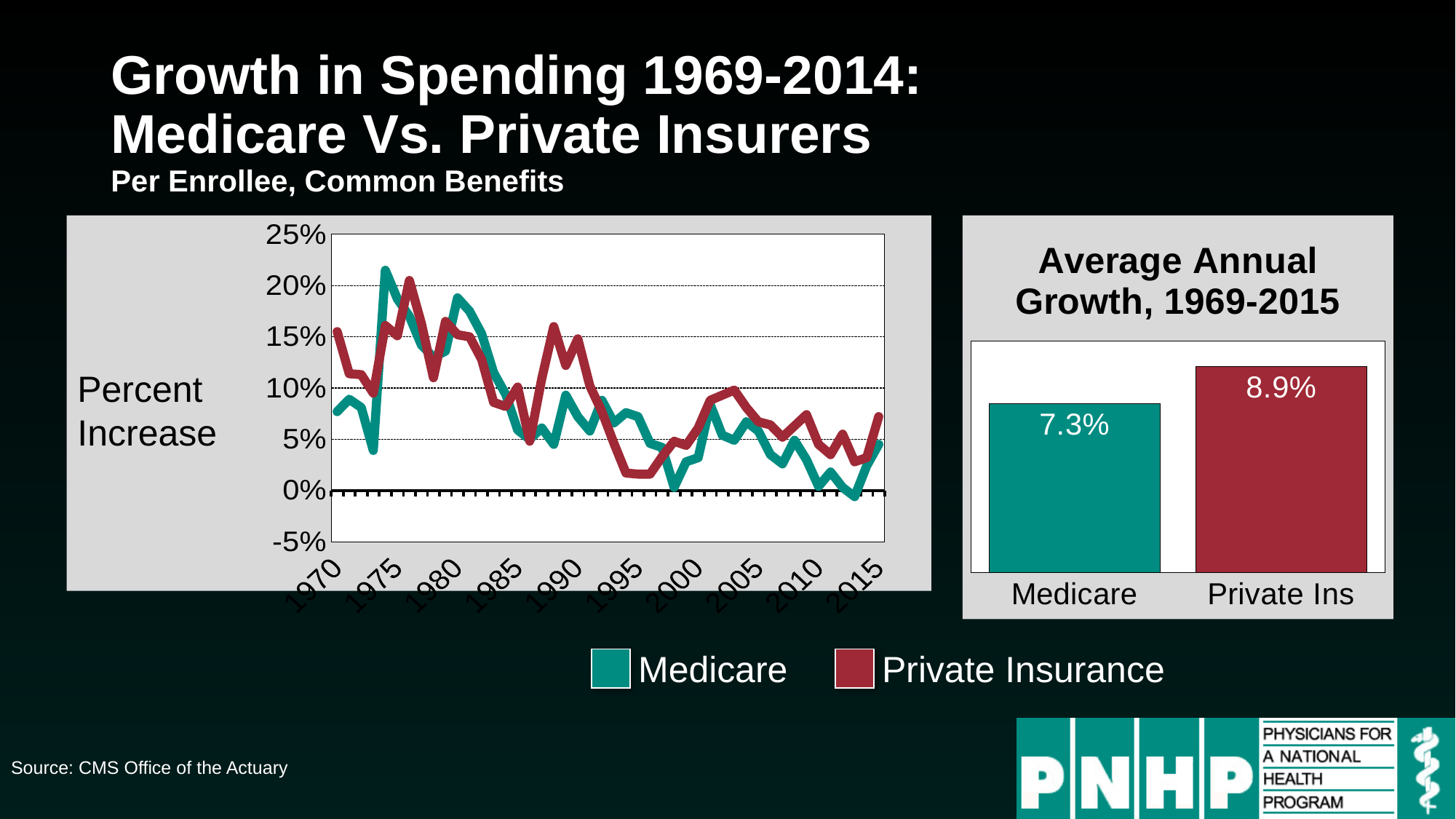
In the Average Annual Growth, 1969-2015 chart, what is the difference between Private Ins and Medicare? 1.6% In the Percent Increase chart on the left, is the Medicare value at 2015 greater or less than 10%? less In the Average Annual Growth, 1969-2015 chart, what is the value for Private Ins? 8.9% In the Percent Increase chart on the left, which series has the higher value around 1990, Medicare or Private Insurance? Private Insurance In the Percent Increase chart on the left, is the Private Insurance value around 1990 greater or less than 10%? greater What kind of chart is the Percent Increase chart on the left? line chart How many categories are shown in the Average Annual Growth, 1969-2015 chart? 2 What kind of chart is the Average Annual Growth, 1969-2015 chart? bar chart In the Average Annual Growth, 1969-2015 chart, which category has the higher value? Private Ins How many series does the legend list for the Percent Increase chart on the left? 2 In the Average Annual Growth, 1969-2015 chart, what is the value for Medicare? 7.3% In the Percent Increase chart on the left, do the values generally rise or fall from 1970 to 2015? fall